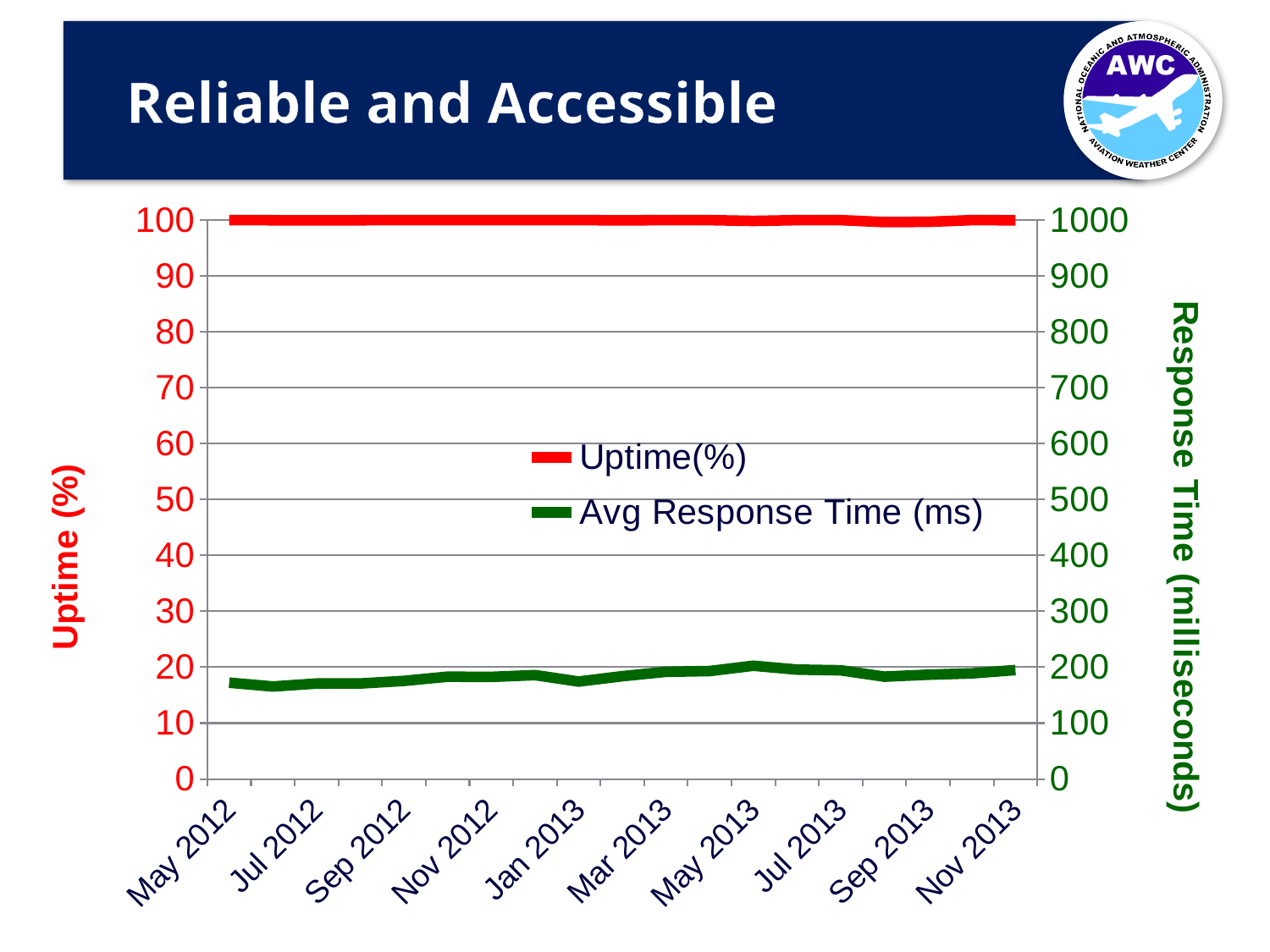
In which month does the Avg Response Time (ms) series reach its highest point? May 2013 Does the Uptime(%) series rise, fall, or stay roughly flat from May 2012 to Nov 2013? roughly flat How many series does the legend list? 2 How many month labels are shown along the x axis? 10 Is the Uptime(%) value for May 2012 greater or less than 80? greater What kind of chart is shown on the slide? line chart Is the Avg Response Time (ms) value for Jul 2012 greater or less than 100? greater Is the Uptime(%) value for Nov 2013 greater or less than 90? greater What is the title of the right-hand vertical axis? Response Time (milliseconds) What are the two series listed in the legend? Uptime(%) and Avg Response Time (ms)